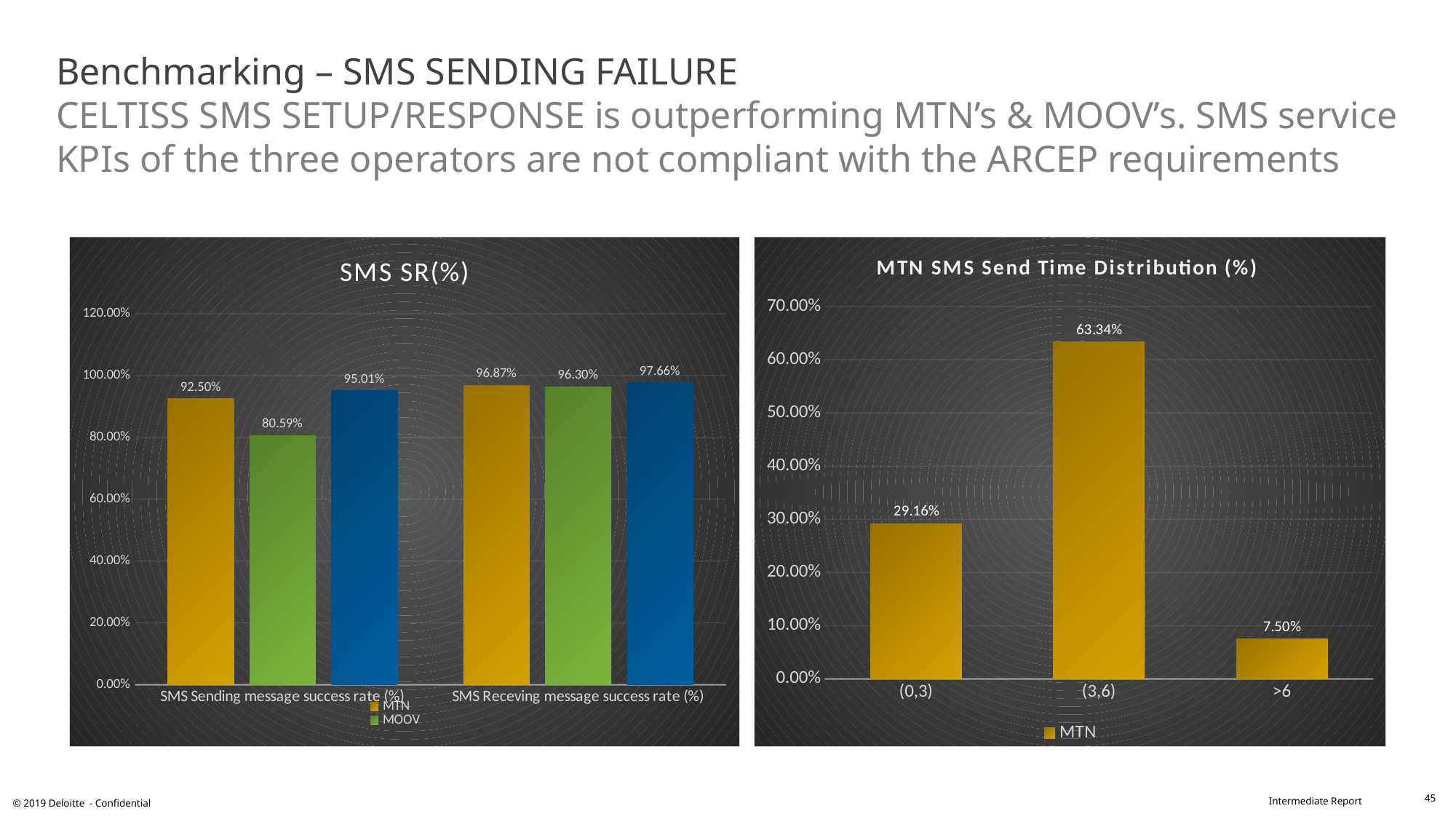
In the MTN SMS Send Time Distribution (%) chart, which category has the lowest value? >6 In the SMS SR(%) chart, what is the difference between MTN and MOOV for SMS Sending message success rate (%)? 11.91% In the SMS SR(%) chart, what is the value for MTN for SMS Sending message success rate (%)? 92.50% In the MTN SMS Send Time Distribution (%) chart, what is the difference between (3,6) and (0,3)? 34.18% In the SMS SR(%) chart, what is the value for MOOV for SMS Sending message success rate (%)? 80.59% In the SMS SR(%) chart, what is the value for MOOV for SMS Receving message success rate (%)? 96.30% In the SMS SR(%) chart, what is the value for MTN for SMS Receving message success rate (%)? 96.87% In the SMS SR(%) chart, how many categories are shown on the x axis? 2 In the MTN SMS Send Time Distribution (%) chart, which category has the highest value? (3,6) In the MTN SMS Send Time Distribution (%) chart, what is the value for >6? 7.50% In the MTN SMS Send Time Distribution (%) chart, what is the value for (3,6)? 63.34% In the SMS SR(%) chart, which is larger for SMS Sending message success rate (%): MTN or MOOV? MTN